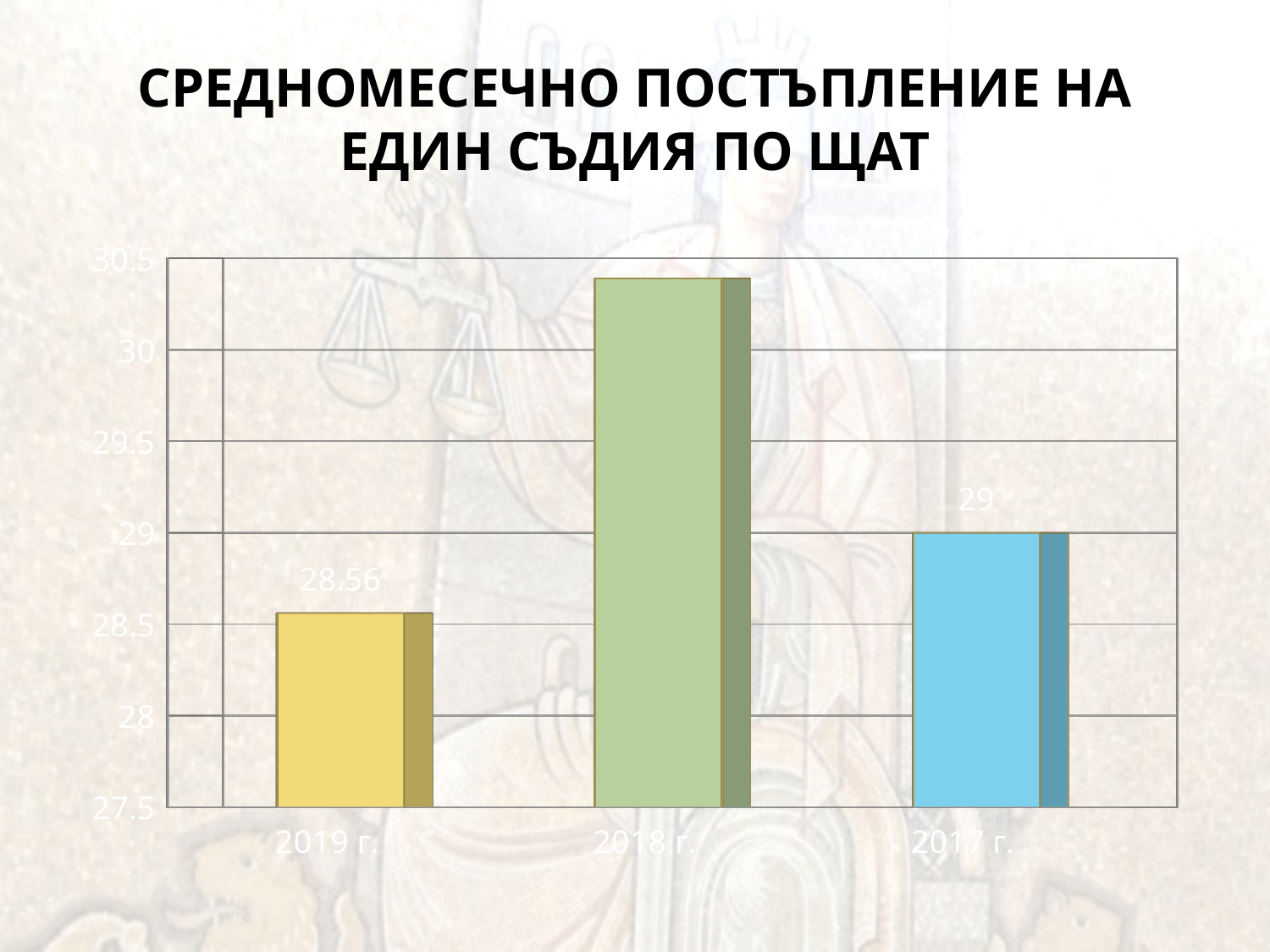
Which is larger, the value for 2017 г. or the value for 2019 г.? 2017 г. How many categories (years) are shown on the chart? 3 What is the title of the chart? СРЕДНОМЕСЕЧНО ПОСТЪПЛЕНИЕ НА ЕДИН СЪДИЯ ПО ЩАТ What kind of chart is shown on the slide? bar chart Which year has the highest bar? 2018 г. What is the value for 2017 г.? 29 What is the value for 2019 г.? 28.56 Which year has the lowest bar? 2019 г. What is the difference between the values for 2017 г. and 2019 г.? 0.44 Is the value for 2018 г. greater or less than 30? greater Does the value rise or fall from 2018 г. to 2017 г. along the x axis? fall Is the value for 2019 г. greater or less than 29? less